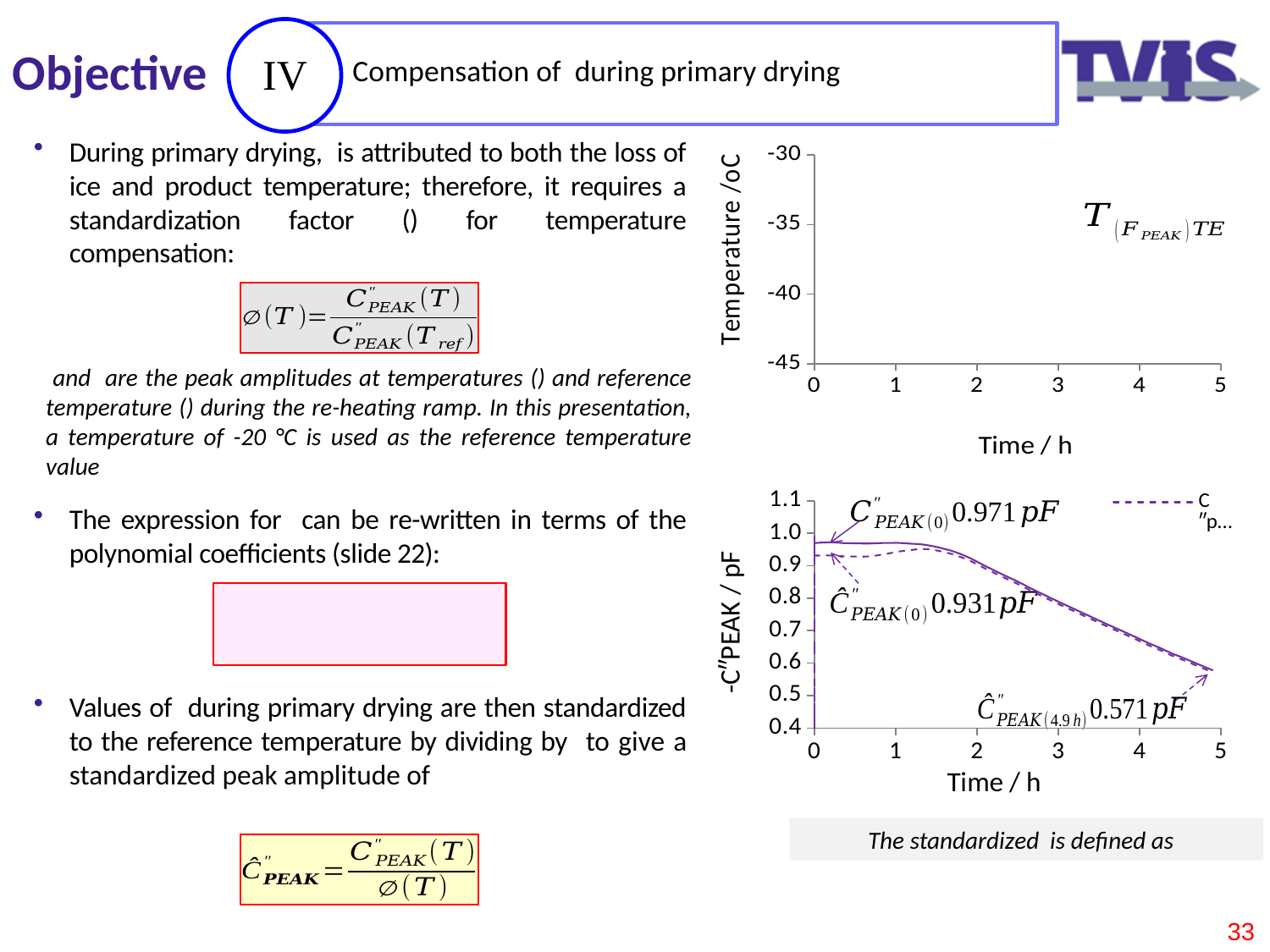
In the bottom chart, what is the annotated value of the standardized Ĉ''PEAK at time 0? 0.931 pF In the bottom chart, is the value of the solid line at 3 h greater or less than 0.7? greater In the bottom chart, what is the annotated value of C''PEAK at time 0? 0.971 pF In the bottom chart, which is larger: C''PEAK at time 0 or Ĉ''PEAK at 4.9 h? C''PEAK at time 0 In the bottom chart, is the value of the solid line at 4 h greater or less than 0.6? greater What kind of chart is the bottom chart on the slide (-C''PEAK / pF versus Time / h)? line chart What is the x-axis title of the bottom chart? Time / h In the bottom chart, do the plotted values rise or fall as time increases from about 1.5 h to 5 h? fall In the bottom chart, by how much does the standardized Ĉ''PEAK fall from time 0 (0.931 pF) to 4.9 h (0.571 pF)? 0.360 pF In the bottom chart, what is the difference between C''PEAK(0) (0.971 pF) and Ĉ''PEAK(0) (0.931 pF)? 0.040 pF What is the y-axis title of the top chart? Temperature /oC In the bottom chart, what is the annotated value of the standardized Ĉ''PEAK at 4.9 h? 0.571 pF